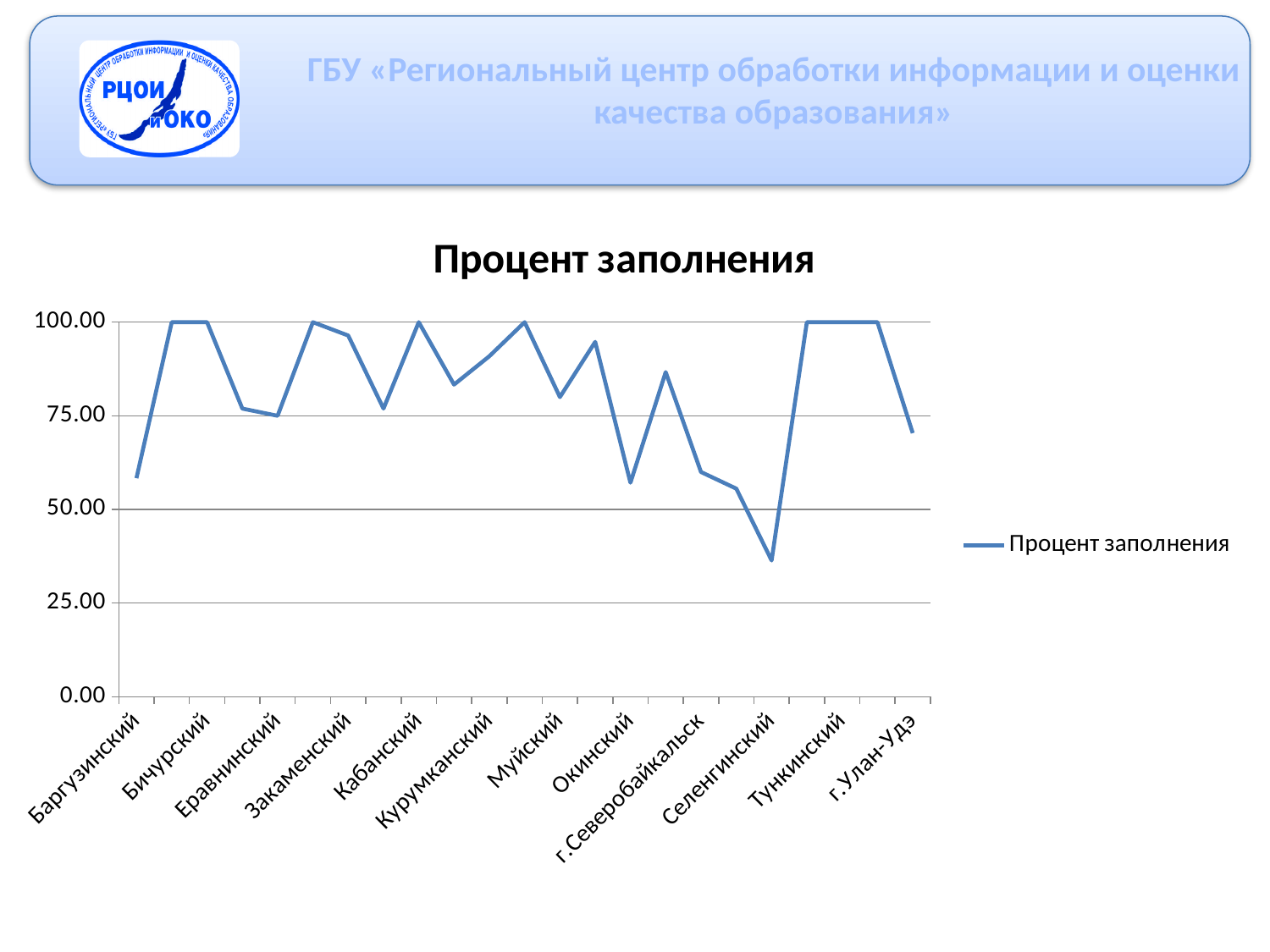
Is the value for Окинский greater or less than 75? less Which is larger, the value for Закаменский or the value for Окинский? Закаменский Which category has the lowest value in the chart? Селенгинский Is the value for Закаменский greater or less than 75? greater What kind of chart is shown on the slide? line chart What is the value for Тункинский? 100.00 Is the value for Селенгинский greater or less than 50? less What is the value for Бичурский? 100.00 How many series does the legend list? 1 What is the title of the chart? Процент заполнения